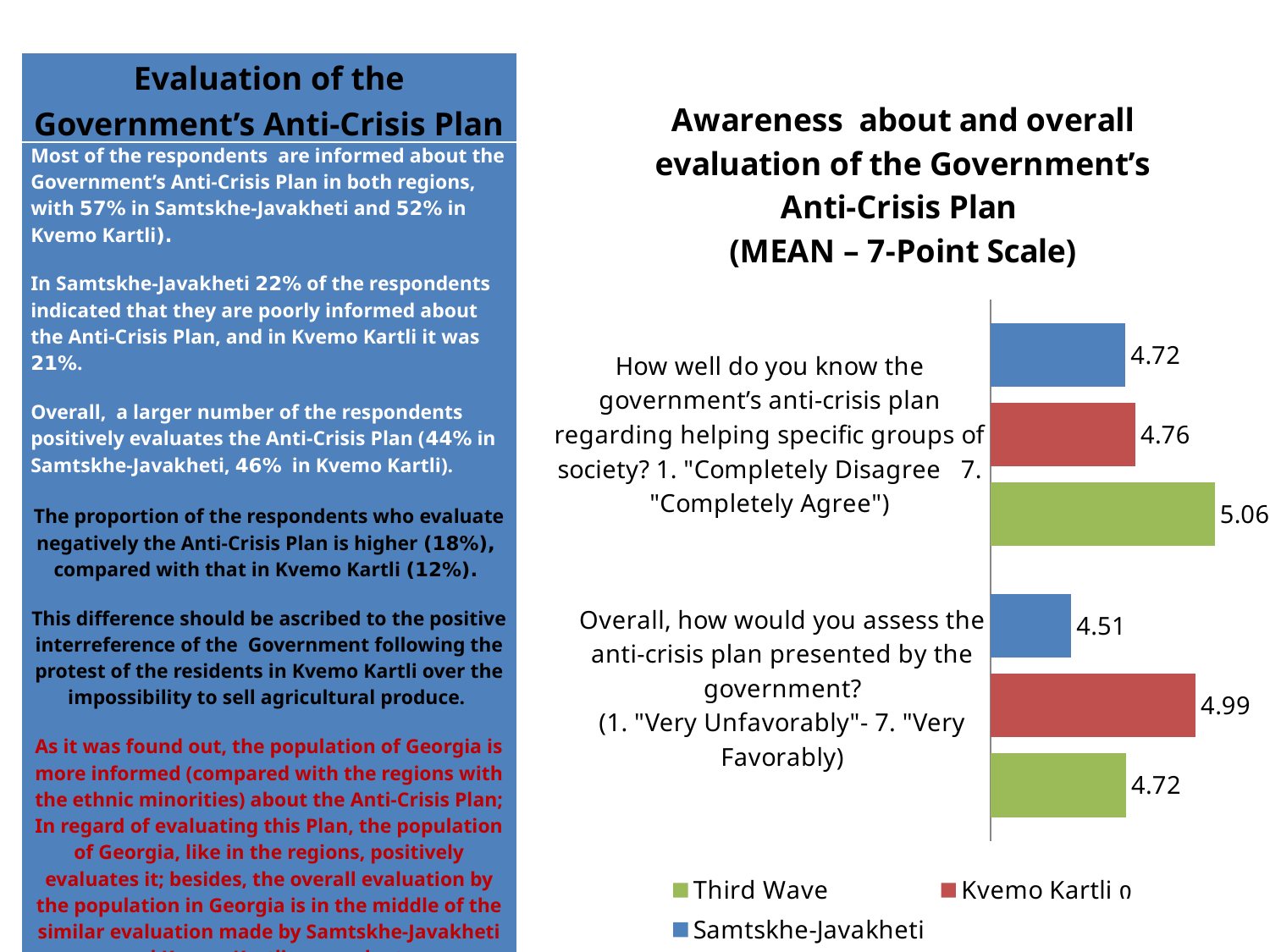
What is the Samtskhe-Javakheti value for the question "Overall, how would you assess the anti-crisis plan presented by the government?" 4.51 What type of chart is shown on the slide? Bar chart Which series has the highest value for the question "Overall, how would you assess the anti-crisis plan presented by the government?" Kvemo Kartli What is the difference between the Kvemo Kartli and Samtskhe-Javakheti values for the question "Overall, how would you assess the anti-crisis plan presented by the government?" 0.48 How many question categories are plotted on the chart? 2 How many series does the chart legend list? 3 What is the difference between the Third Wave and Samtskhe-Javakheti values for the question "How well do you know the government's anti-crisis plan regarding helping specific groups of society?" 0.34 What is the Kvemo Kartli value for the question "How well do you know the government's anti-crisis plan regarding helping specific groups of society?" 4.76 For the Third Wave series, which question has the larger value: the one about how well respondents know the plan, or the one about overall assessment of the plan? How well do you know the government's anti-crisis plan What is the Kvemo Kartli value for the question "Overall, how would you assess the anti-crisis plan presented by the government?" 4.99 What is the Third Wave value for the question "How well do you know the government's anti-crisis plan regarding helping specific groups of society?" 5.06 Which series has the lowest value for the question "How well do you know the government's anti-crisis plan regarding helping specific groups of society?" Samtskhe-Javakheti